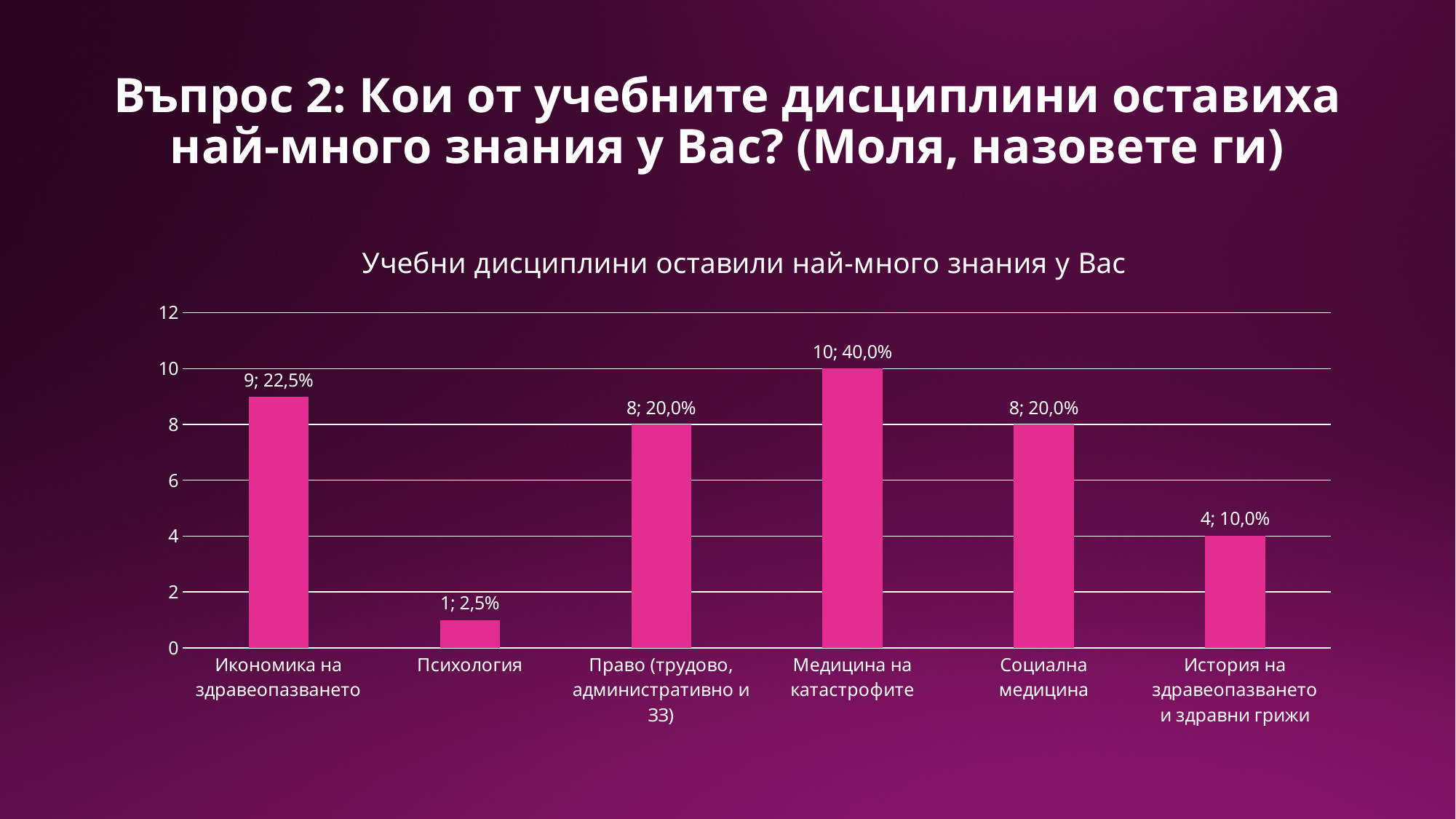
Which category has the lowest value? Психология Which is larger: the value for Икономика на здравеопазването or the value for Право (трудово, административно и ЗЗ)? Икономика на здравеопазването How many categories are shown on the x axis of the chart? 6 What is the difference between the count for Медицина на катастрофите and the count for Социална медицина? 2 What percentage is shown for Психология? 2,5% Which category has the highest value? Медицина на катастрофите What is the data label shown for Медицина на катастрофите? 10; 40,0% What is the title of the chart? Учебни дисциплини оставили най-много знания у Вас Is the value for История на здравеопазването и здравни грижи greater or less than 6? less What is the data label for История на здравеопазването и здравни грижи? 4; 10,0% What type of chart is shown on the slide? Bar chart What is the count value for Икономика на здравеопазването? 9